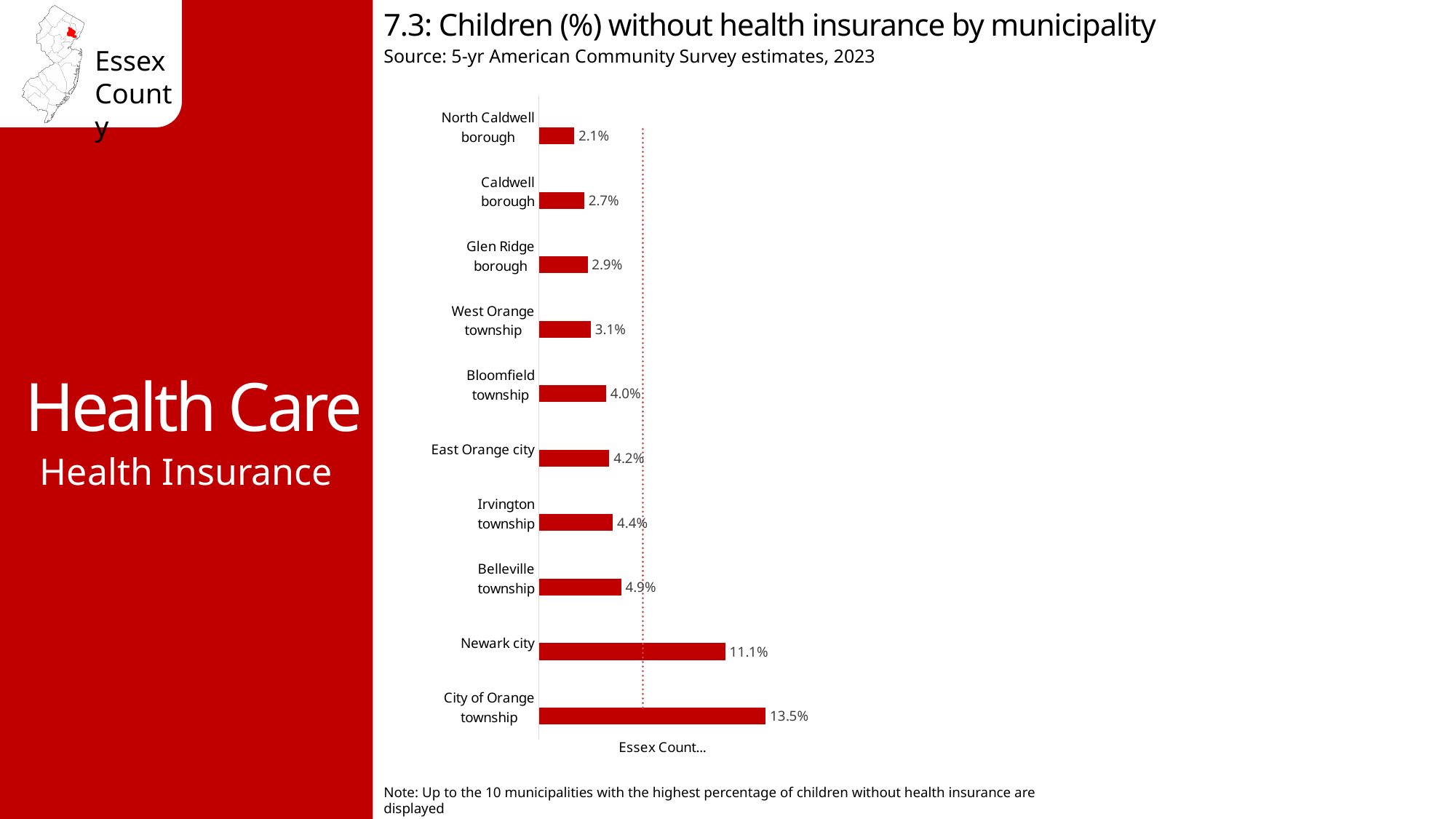
What is the value shown for Bloomfield township? 4.0% What is the difference between the values for City of Orange township and Newark city? 2.4% How many municipalities are shown in the chart? 10 What percentage of children in Newark city are without health insurance? 11.1% What kind of chart is shown on the slide? Bar chart What is the difference between the values for Belleville township and Caldwell borough? 2.2% Which municipality has the highest percentage of children without health insurance? City of Orange township Which has a higher value, Irvington township or West Orange township? Irvington township Which municipality has the lowest percentage of children without health insurance? North Caldwell borough What is the title of the chart? 7.3: Children (%) without health insurance by municipality What is the value shown for Glen Ridge borough? 2.9% What is the source of the data shown in the chart? 5-yr American Community Survey estimates, 2023